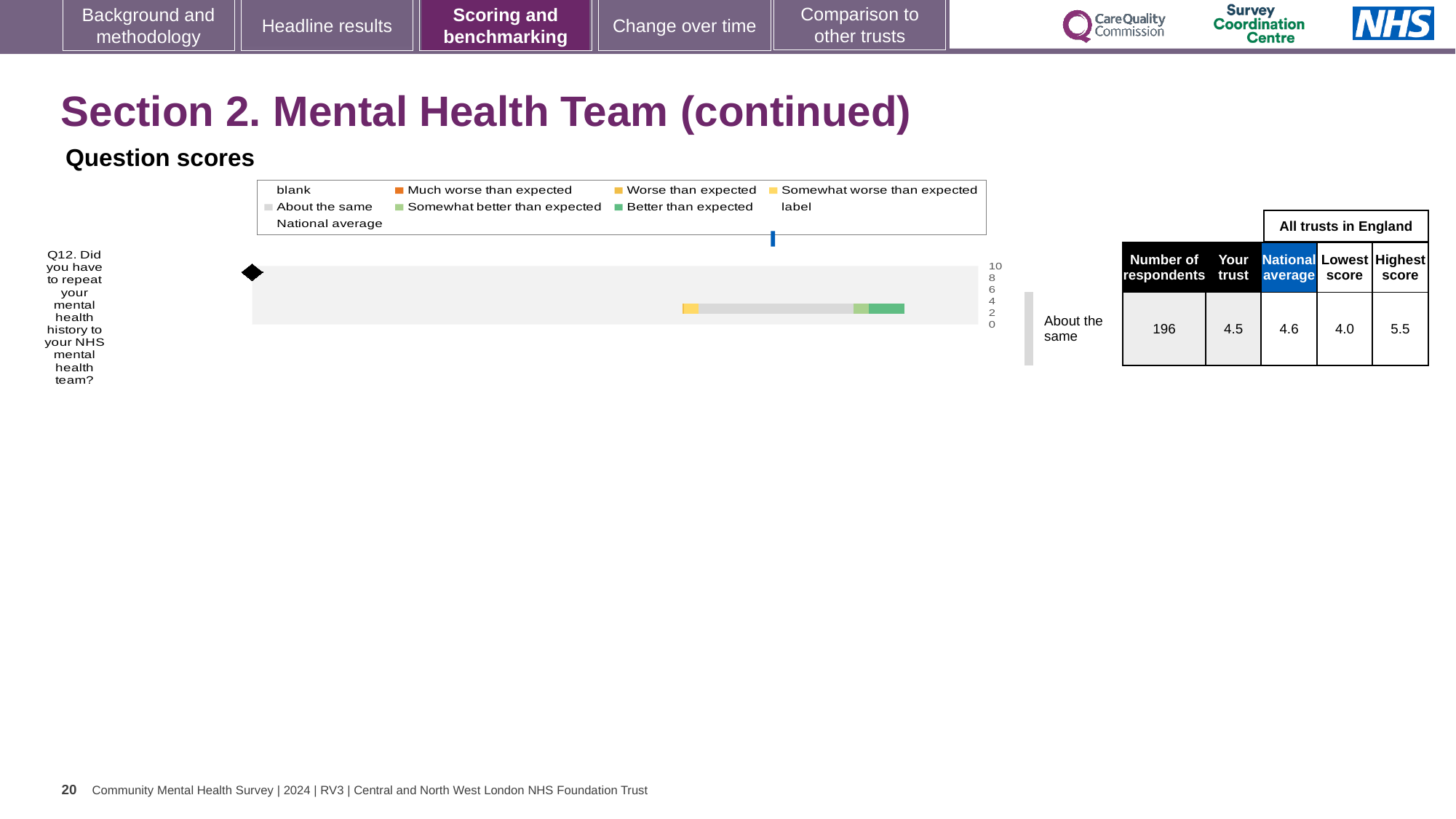
What benchmark category label is shown next to the Q12 bar? About the same What does the blue marker on the chart represent, according to the legend? National average How many survey questions are plotted on the chart? 1 What is the highest score among all trusts in England for Q12? 5.5 Which is larger for Q12: the 'Your trust' score or the national average? National average What is the lowest score among all trusts in England for Q12? 4.0 What is the national average score for Q12? 4.6 What is the difference between the highest score and the lowest score for Q12? 1.5 How many respondents answered Q12? 196 By how much does the national average exceed the 'Your trust' score for Q12? 0.1 What is the 'Your trust' score for Q12 (repeating mental health history to the NHS mental health team)? 4.5 What kind of chart is used to show the Q12 question score? bar chart